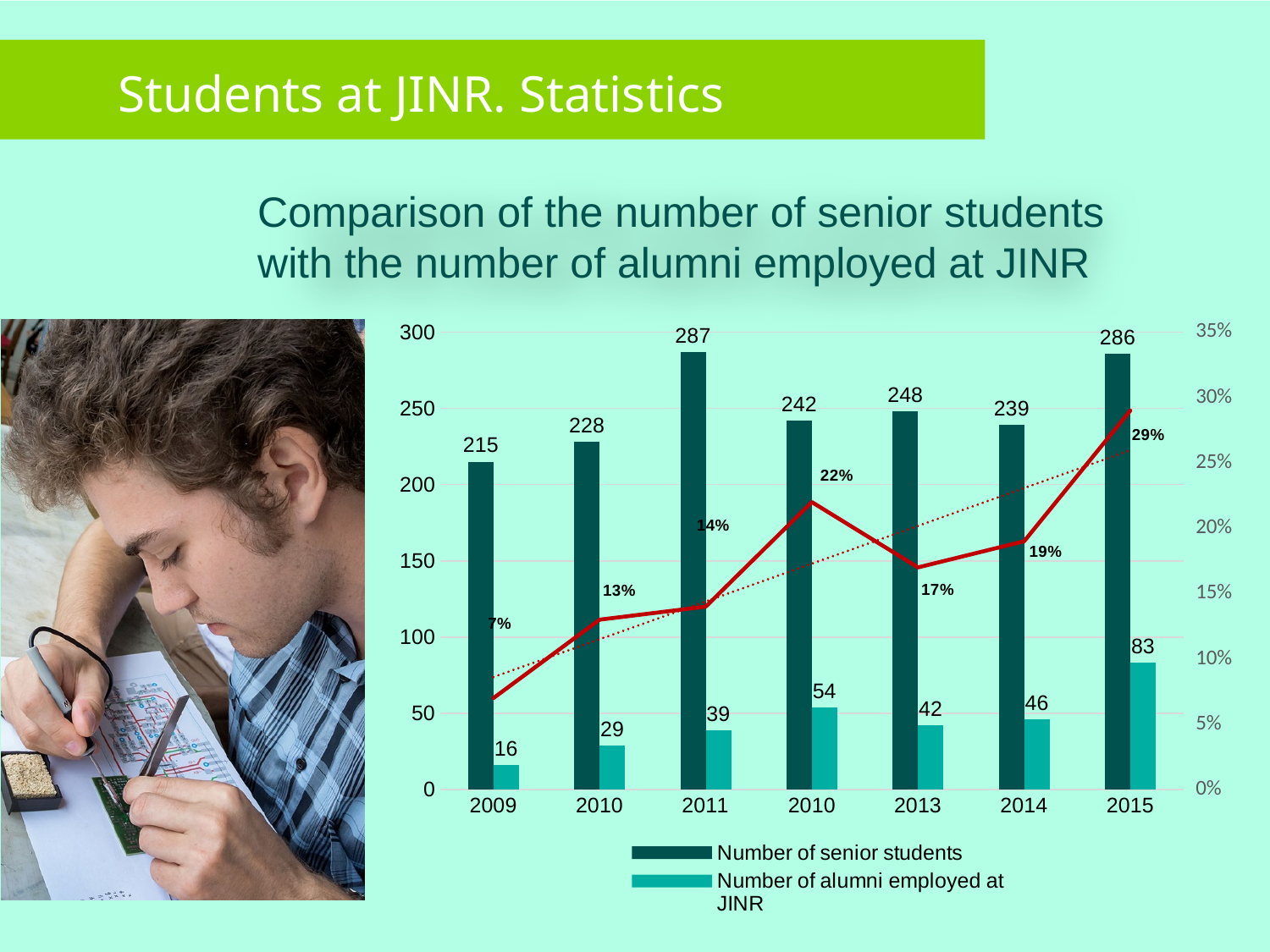
What percentage label is shown on the red line for 2015? 29% In which year is the number of senior students highest? 2011 How many series does the legend list? 2 In which year is the number of alumni employed at JINR lowest? 2009 How many years are shown on the x axis of the chart? 7 How many senior students are shown for 2011? 287 Which year has more alumni employed at JINR, 2013 or 2014? 2014 What is the number of alumni employed at JINR in 2015? 83 What kind of chart is used to show the number of senior students and alumni? bar chart Does the number of alumni employed at JINR rise or fall from 2013 to 2015? rise What is the difference between the number of senior students and the number of alumni employed at JINR in 2015? 203 Is the number of senior students in 2009 greater or less than 200? greater